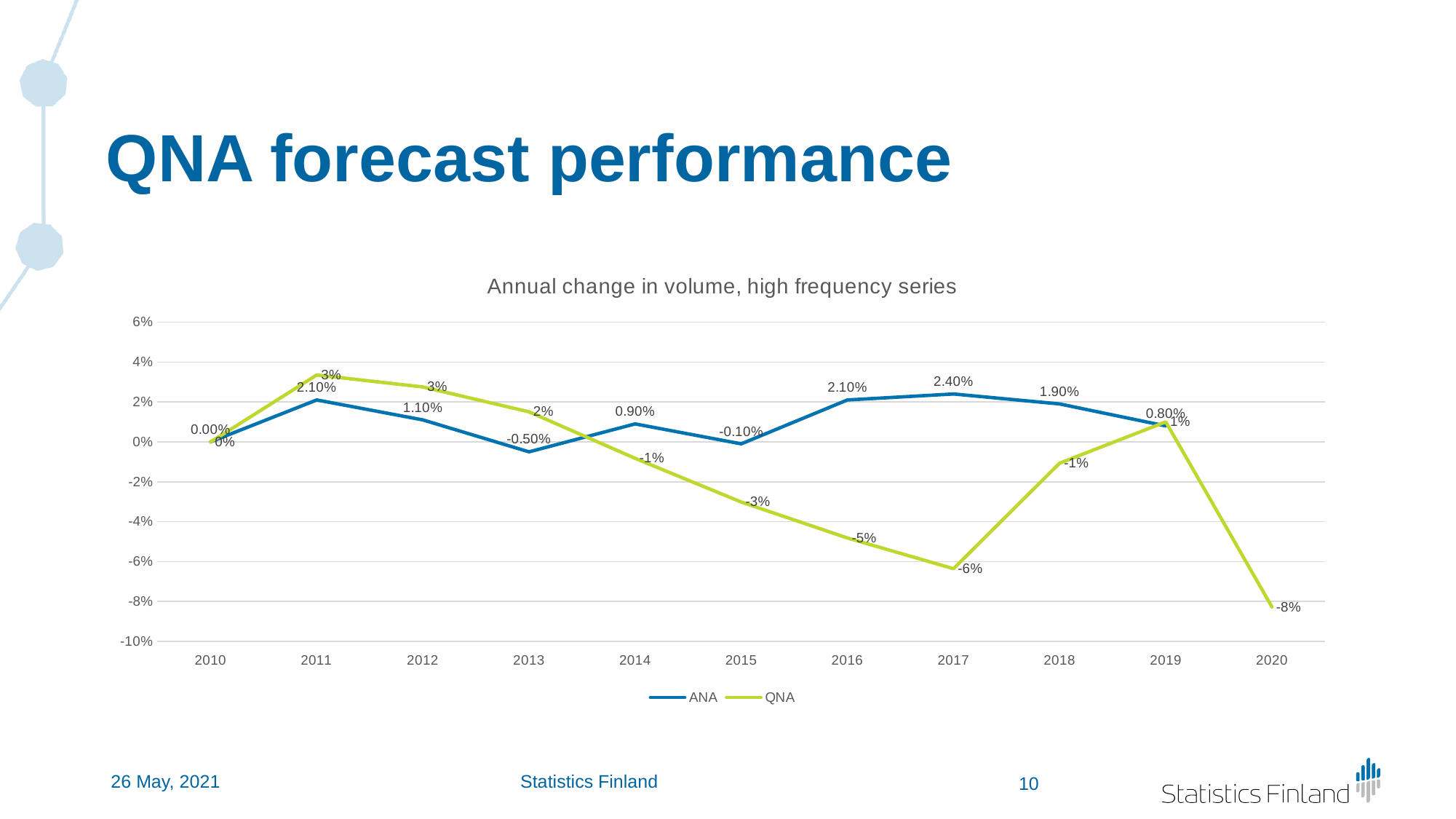
In 2015, which series has the larger value, ANA or QNA? ANA How many series does the legend list? 2 In which year does the QNA series reach its lowest value? 2020 What is the title of the chart? Annual change in volume, high frequency series What is the difference between the ANA values for 2017 and 2016? 0.30% What kind of chart is shown on the slide? Line chart What is the QNA value for 2020? -8% In which year does the ANA series reach its highest value? 2017 Does the QNA series rise or fall from 2013 to 2017? Fall What is the ANA value for 2013? -0.50% What is the ANA value for 2017? 2.40% How many years are shown on the x axis? 11